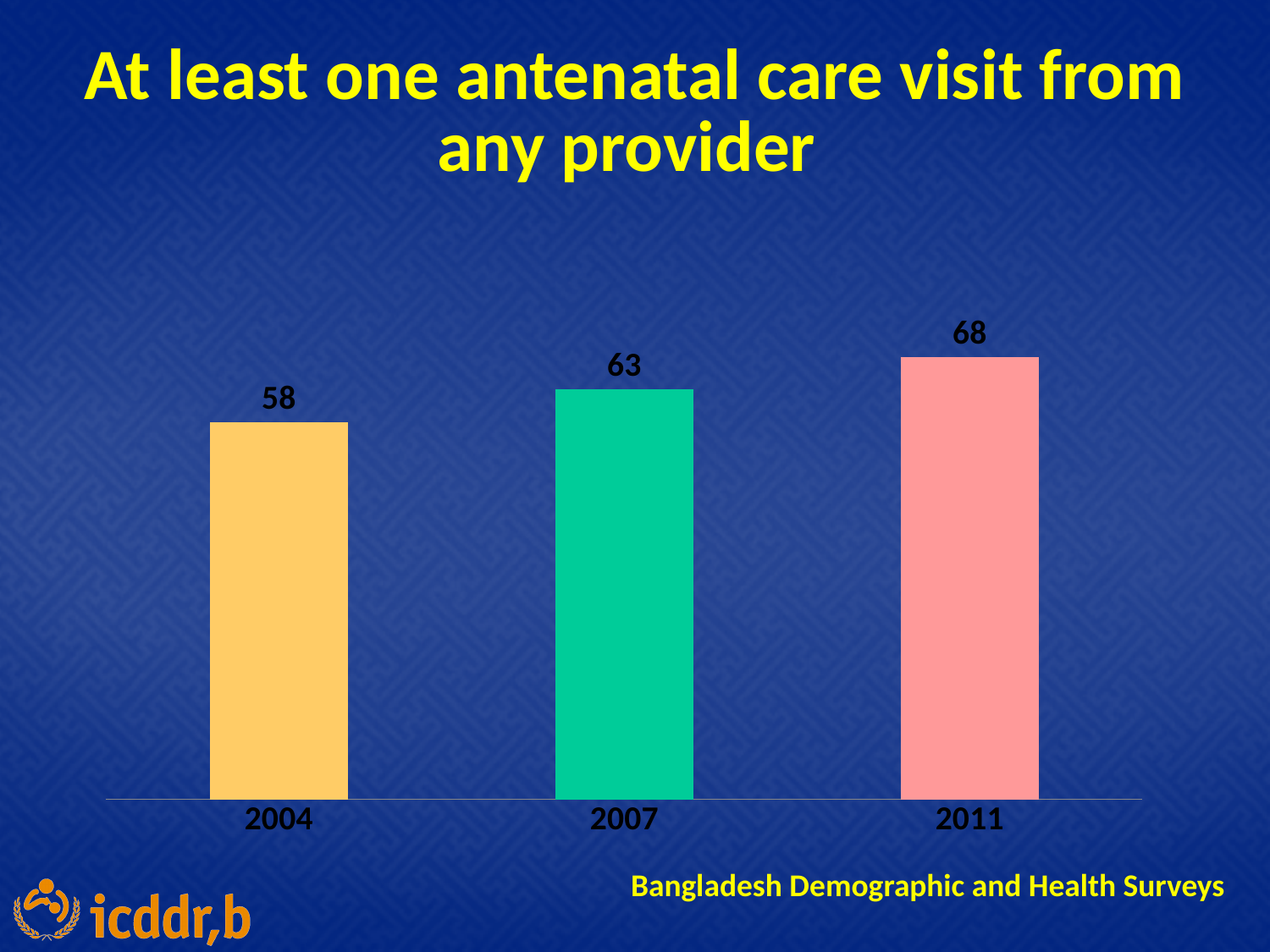
Which is larger, the value for 2007 or the value for 2011? 2011 Do the values rise or fall from 2004 to 2011? rise What is the difference between the values for 2011 and 2004? 10 What kind of chart is shown on the slide? bar chart Which year has the lowest value? 2004 What is the value for 2007? 63 How many years are shown on the chart? 3 What is the difference between the values for 2007 and 2004? 5 What is the value for 2011? 68 Which year has the highest value? 2011 What is the value for 2004? 58 What is the title of the chart? At least one antenatal care visit from any provider